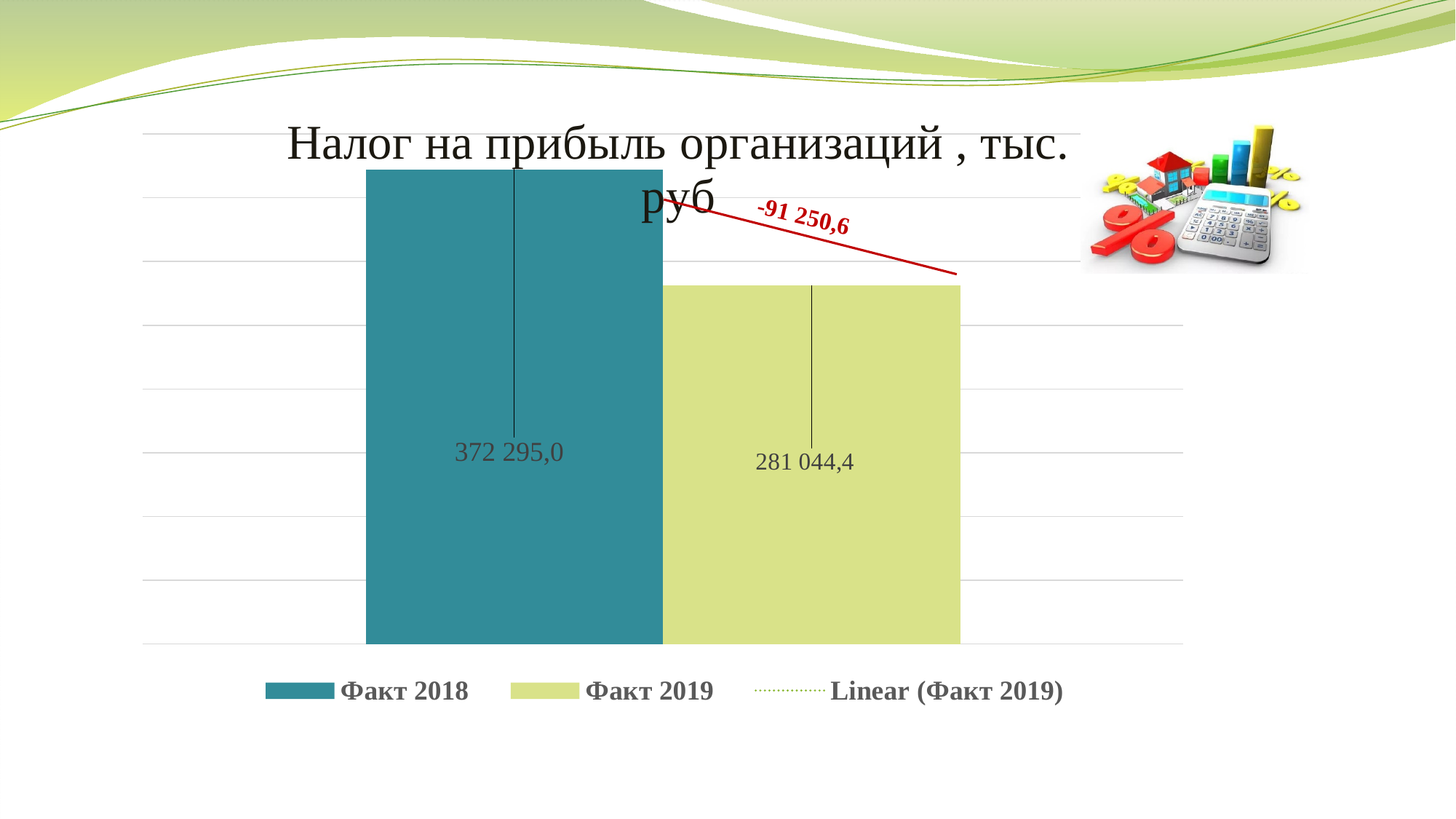
How many bars are plotted on the chart? 2 What change value is written in red above the bars? -91 250,6 What is the value for Факт 2019? 281 044,4 What is the title of the chart? Налог на прибыль организаций , тыс. руб How many entries does the legend list? 3 Which series has the lower value, Факт 2018 or Факт 2019? Факт 2019 Do the values rise or fall from Факт 2018 to Факт 2019? fall Is the value for Факт 2019 larger or smaller than the value for Факт 2018? smaller Which series has the higher value, Факт 2018 or Факт 2019? Факт 2018 What is the difference between the Факт 2018 value and the Факт 2019 value? 91 250,6 What is the value for Факт 2018? 372 295,0 What kind of chart is shown on the slide? bar chart